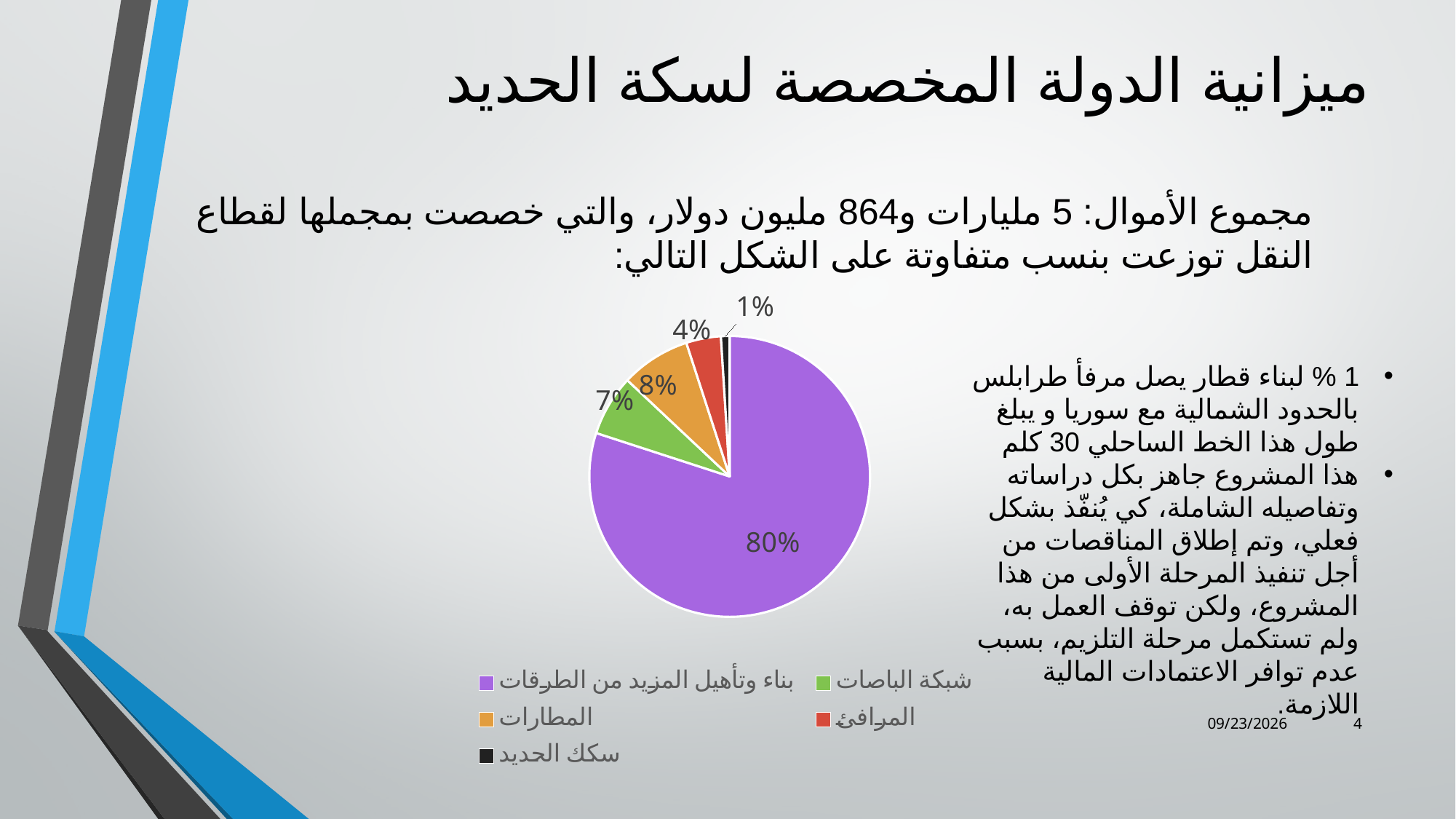
Which category has the largest slice of the pie? بناء وتأهيل المزيد من الطرقات How many slices does the pie chart have? 5 What share of the pie does شبكة الباصات have? 7% What colour is the slice for سكك الحديد? black What share of the pie does المرافئ have? 4% What kind of chart is shown on the slide? pie chart What is the difference between the shares of المطارات and المرافئ? 4% Which is larger, the share for المطارات or the share for شبكة الباصات? المطارات What share of the pie does المطارات have? 8% Which category has the smallest slice of the pie? سكك الحديد